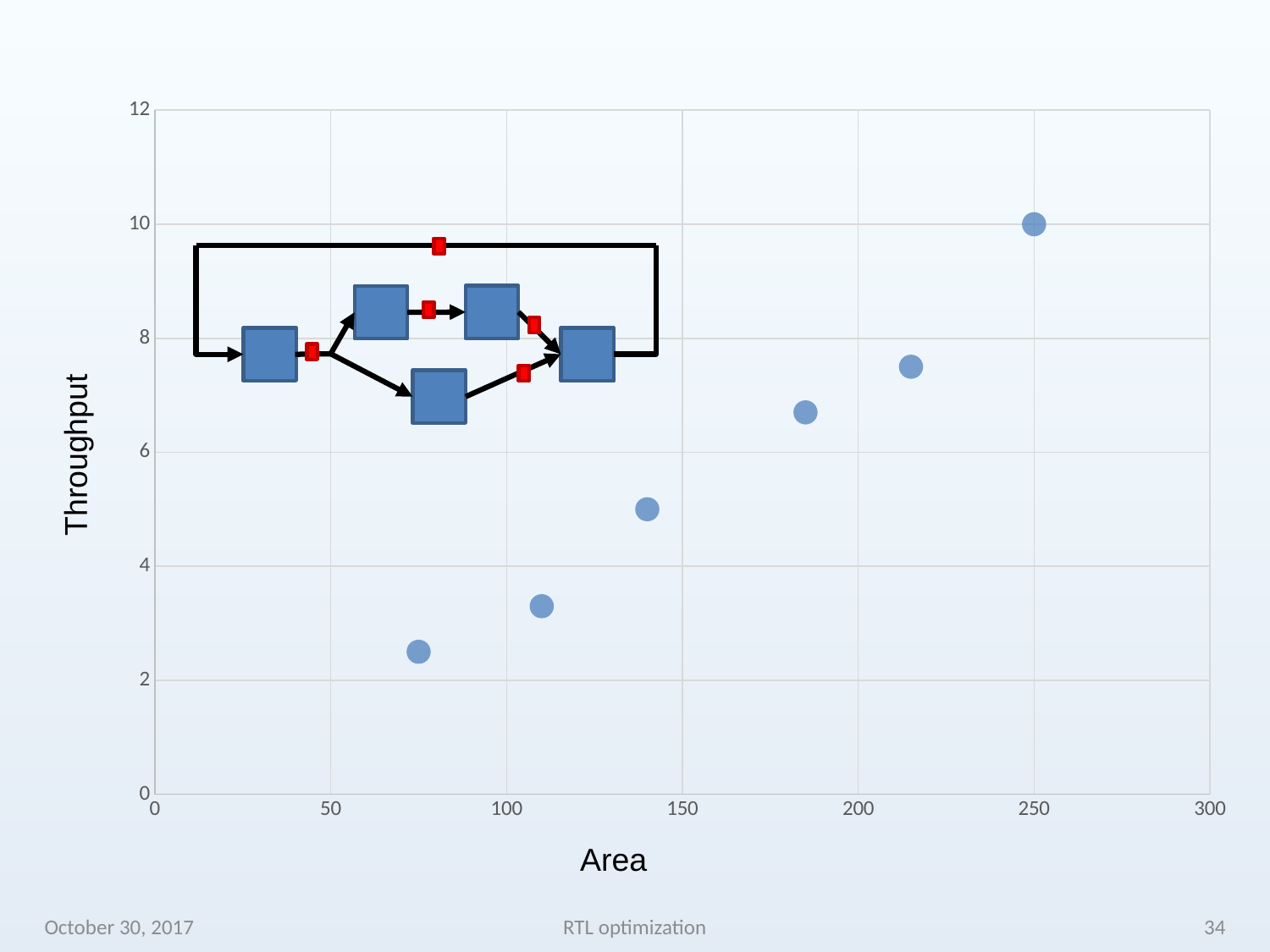
How many data points are plotted in the chart? 6 What is the label of the y axis? Throughput What kind of chart is shown on the slide? scatter chart What is the label of the x axis? Area Is the Throughput of the point at Area 140 greater or less than 6? less Is the Throughput of the point near Area 185 greater or less than 6? greater Which has the higher Throughput: the point near Area 185 or the point near Area 215? the point near Area 215 What is the Throughput of the rightmost point, at Area 250? 10 Which point has the highest Throughput: the leftmost point or the rightmost point? the rightmost point Is the Throughput of the leftmost point greater or less than 4? less Does Throughput generally rise or fall as Area increases? rise